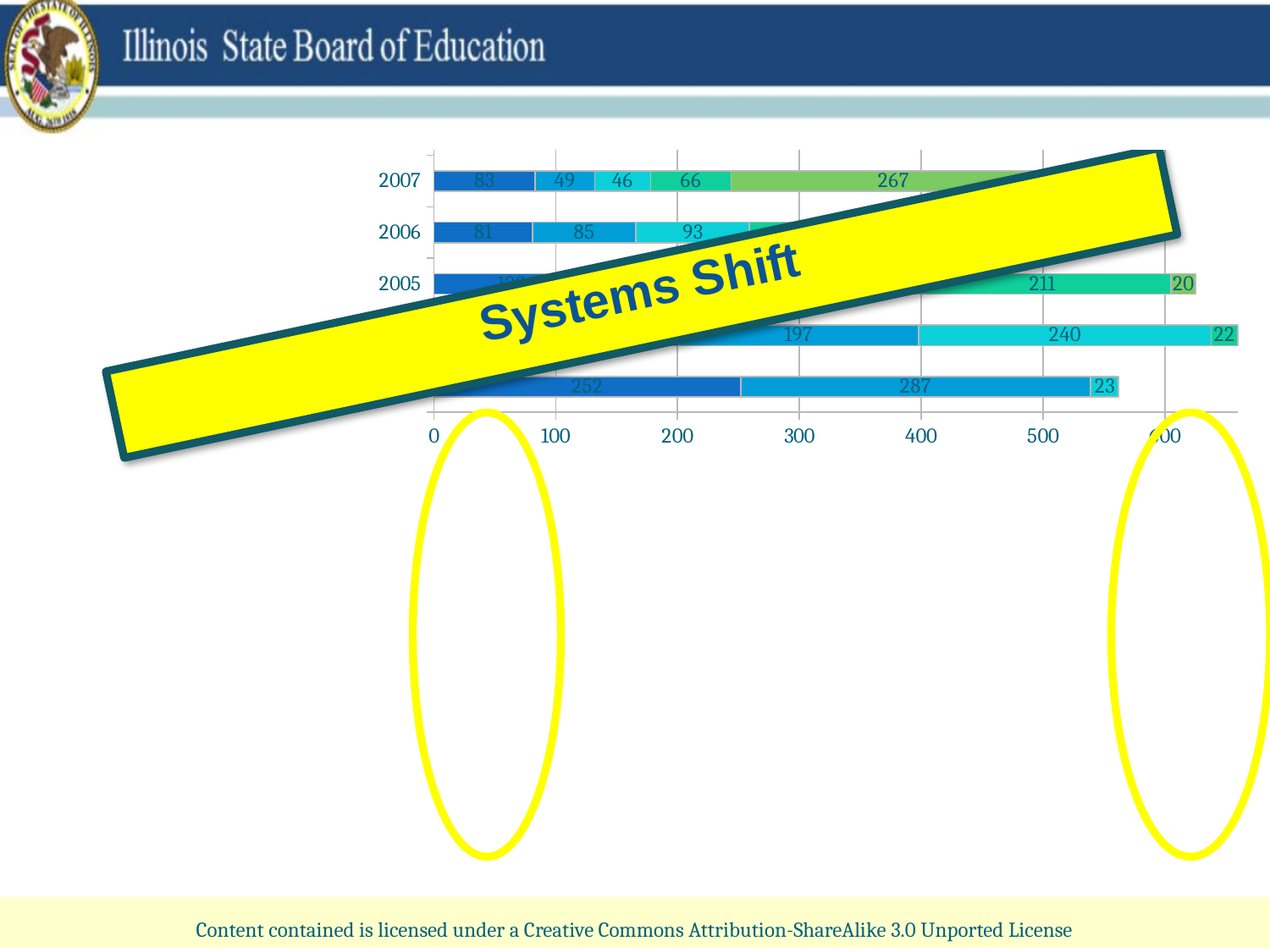
What is the value of the first (leftmost) segment of the 2007 bar? 83 Which segment of the 2007 bar has the smallest value? 46 Which segment of the 2007 bar has the largest value? 267 What kind of chart is shown on the slide? bar chart What is the value of the first (leftmost) segment of the 2006 bar? 81 Is the total length of the 2007 bar greater or less than 400? greater What is the value of the third segment of the 2006 bar? 93 What is the total of all segments in the 2007 bar? 511 What is the value of the last (rightmost) segment of the 2005 bar? 20 How many segments make up the 2007 bar? 5 What is the value of the last (rightmost) segment of the 2007 bar? 267 What is the difference between the largest segment (267) and the first segment (83) of the 2007 bar? 184